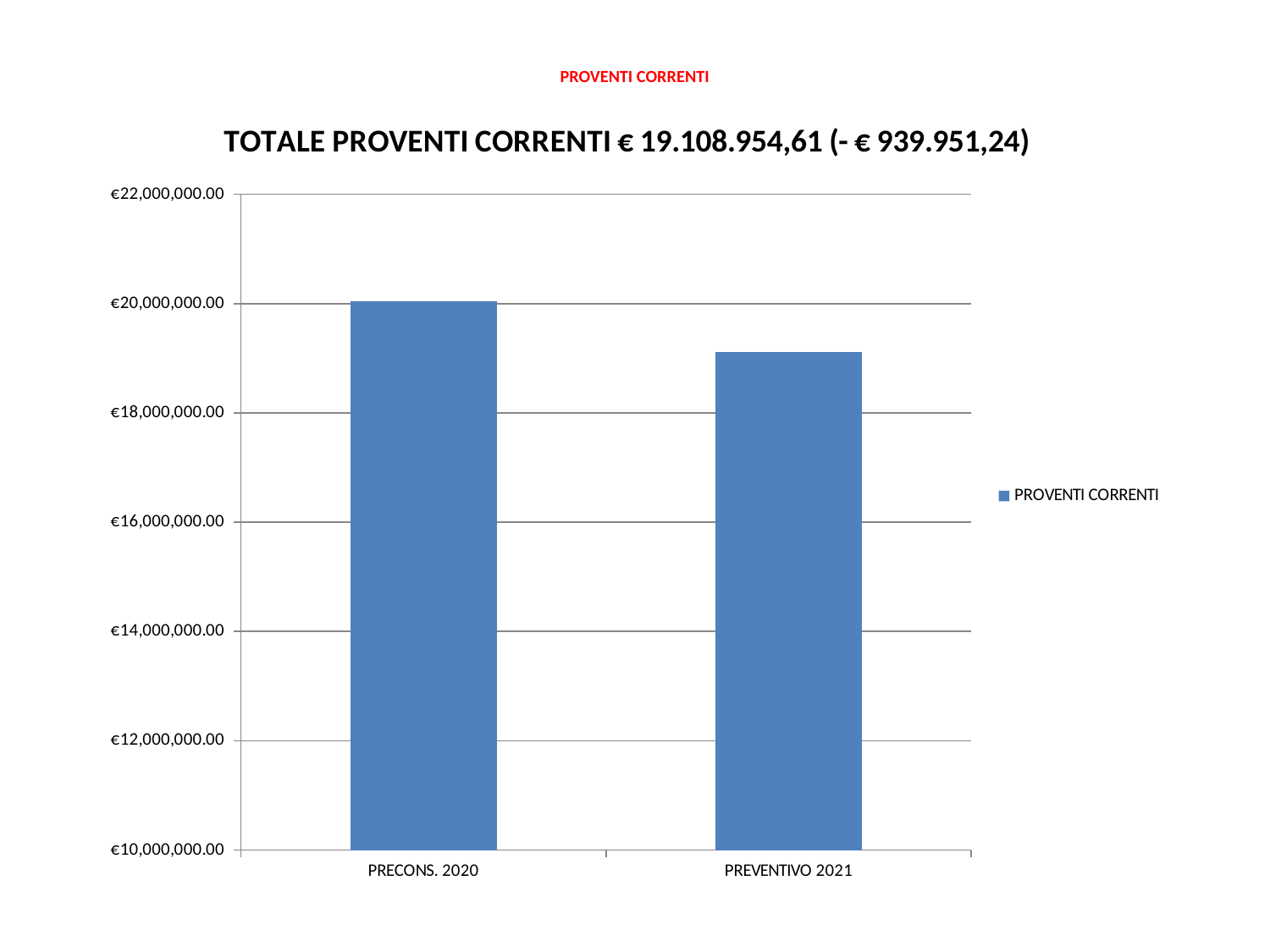
Which category has the highest value? PRECONS. 2020 How many bars (categories) are plotted in the chart? 2 Which is larger, the value for PRECONS. 2020 or the value for PREVENTIVO 2021? PRECONS. 2020 What kind of chart is shown on the slide? bar chart How many series does the legend list? 1 Is the value for PREVENTIVO 2021 greater or less than €20,000,000.00? less What is the title of the chart? TOTALE PROVENTI CORRENTI € 19.108.954,61 (- € 939.951,24) Is the value for PRECONS. 2020 greater or less than €18,000,000.00? greater Is the value for PREVENTIVO 2021 greater or less than €18,000,000.00? greater What series name is shown in the chart legend? PROVENTI CORRENTI Which category has the lowest value? PREVENTIVO 2021 Do the values rise or fall from PRECONS. 2020 to PREVENTIVO 2021? fall